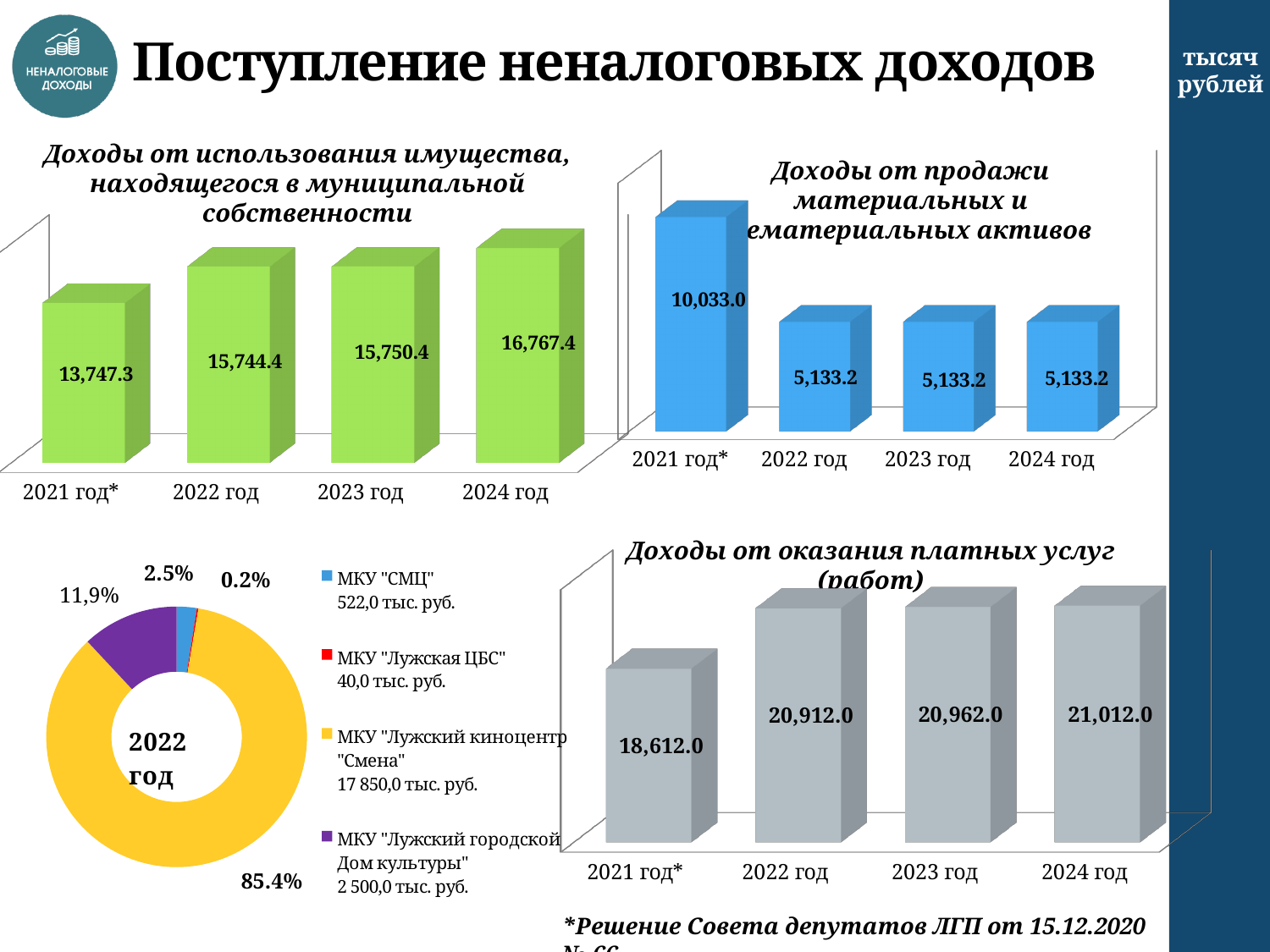
In the chart 'Доходы от оказания платных услуг (работ)', which is larger, the value for 2021 год* or 2024 год? 2024 год In the chart 'Доходы от использования имущества, находящегося в муниципальной собственности', which year has the lowest value? 2021 год* In the chart 'Доходы от продажи материальных и нематериальных активов', what is the value for 2021 год*? 10,033.0 In the chart 'Доходы от использования имущества, находящегося в муниципальной собственности', do the values rise or fall from 2021 год* to 2024 год? rise How many entries does the legend of the donut chart labelled '2022 год' list? 4 In the chart 'Доходы от использования имущества, находящегося в муниципальной собственности', what is the value for 2024 год? 16,767.4 In the chart 'Доходы от оказания платных услуг (работ)', what is the value for 2022 год? 20,912.0 In the chart 'Доходы от продажи материальных и нематериальных активов', which year has the highest value? 2021 год* In the chart 'Доходы от продажи материальных и нематериальных активов', what is the difference between the values for 2021 год* and 2022 год? 4,899.8 In the chart 'Доходы от оказания платных услуг (работ)', how many years are shown? 4 In the donut chart labelled '2022 год' at the bottom left, what share does МКУ "Лужский киноцентр "Смена" have? 85.4% In the chart 'Доходы от использования имущества, находящегося в муниципальной собственности', what is the difference between the values for 2024 год and 2021 год*? 3,020.1